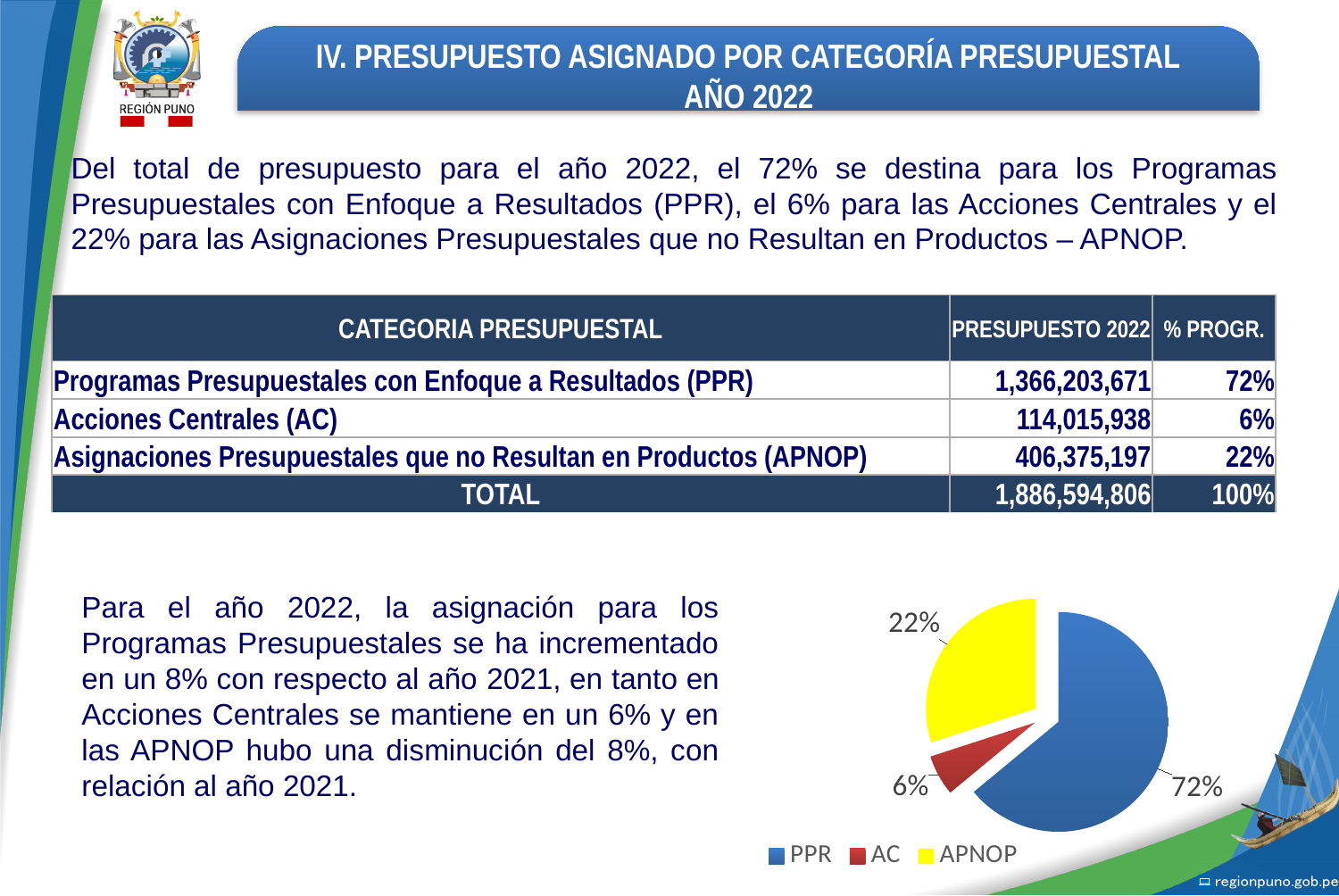
Which slice is larger, APNOP or AC? APNOP What colour is the APNOP slice in the pie chart? yellow What colour is the PPR slice in the pie chart? blue Which category has the smallest slice of the pie? AC Which category has the largest slice of the pie? PPR What is the difference in percentage points between the PPR slice and the APNOP slice? 50% What share of the pie does PPR represent? 72% How many entries does the legend of the pie chart list? 3 What kind of chart is shown on the slide? pie chart How many slices does the pie chart have? 3 What share of the pie does AC represent? 6% What share of the pie does APNOP represent? 22%